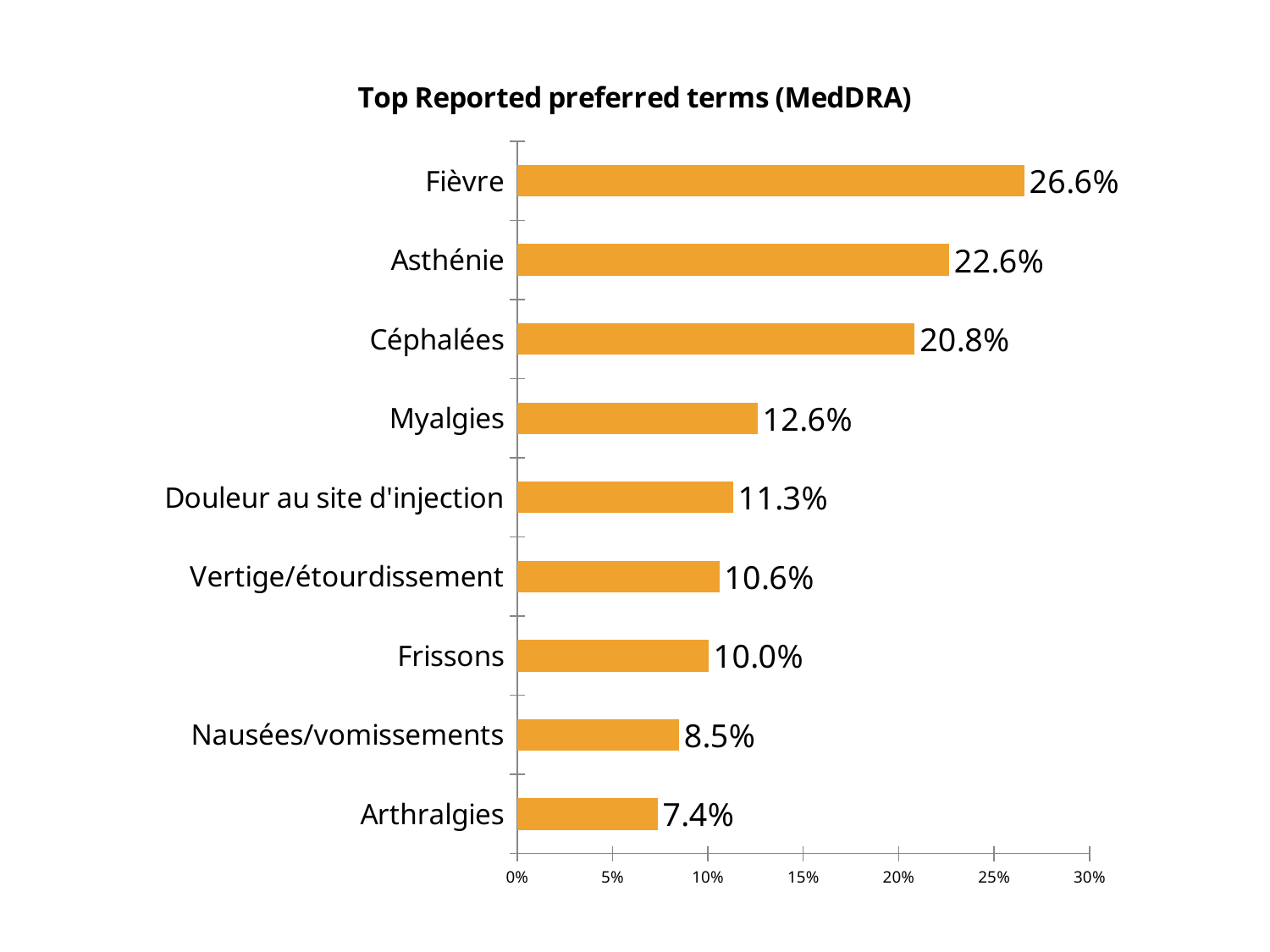
Which category has the lowest value? Arthralgies What is the difference between the values for Fièvre and Asthénie? 4.0% What kind of chart is shown on the slide? bar chart What is the value for Douleur au site d'injection? 11.3% What is the value for Fièvre? 26.6% Which category has the highest value? Fièvre What is the value for Nausées/vomissements? 8.5% What is the difference between the values for Myalgies and Frissons? 2.6% How many categories are shown in the chart? 9 Which is larger, the value for Céphalées or the value for Myalgies? Céphalées What is the title of the chart? Top Reported preferred terms (MedDRA) Is the value for Vertige/étourdissement greater or less than 15%? less